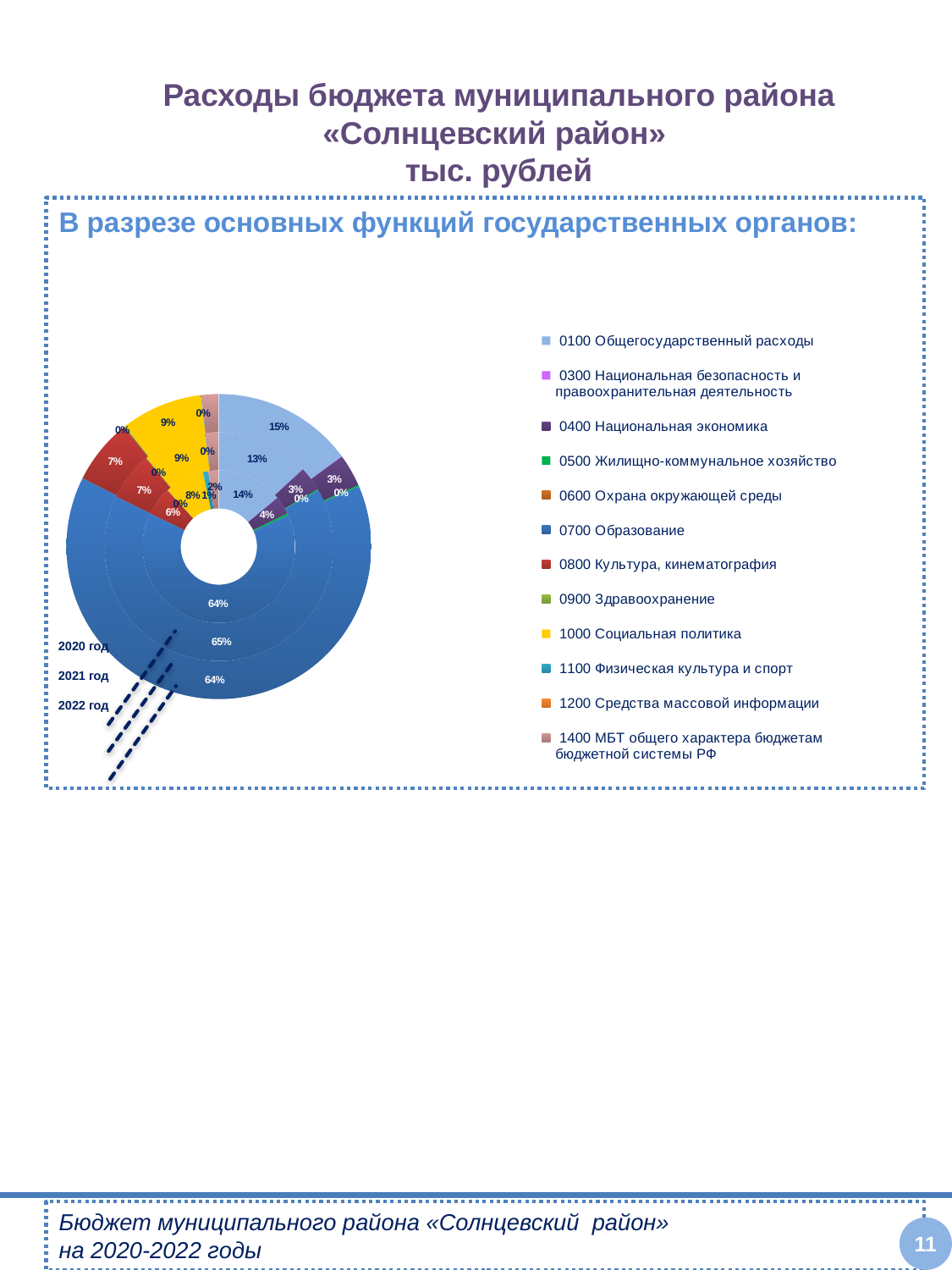
What is the share of 0100 Общегосударственный расходы in the outer ring of the chart? 15% How many categories does the chart legend list? 12 In the outer ring, which is larger: the share of 0700 Образование or the share of 0100 Общегосударственный расходы? 0700 Образование Which category has the largest share in every ring of the chart? 0700 Образование Which years are labelled next to the rings of the chart? 2020 год, 2021 год, 2022 год In the outer ring, what is the difference between the share of 0100 Общегосударственный расходы (15%) and 0800 Культура, кинематография (7%)? 8% How many rings (years) does the doughnut chart have? 3 What is the share of 0700 Образование in the outer ring of the chart? 64% What is the share of 0700 Образование in the middle ring of the chart? 65% What is the share of 1000 Социальная политика in the outer ring of the chart? 9% What is the share of 0100 Общегосударственный расходы in the middle ring of the chart? 13% What kind of chart is shown on the slide? doughnut chart